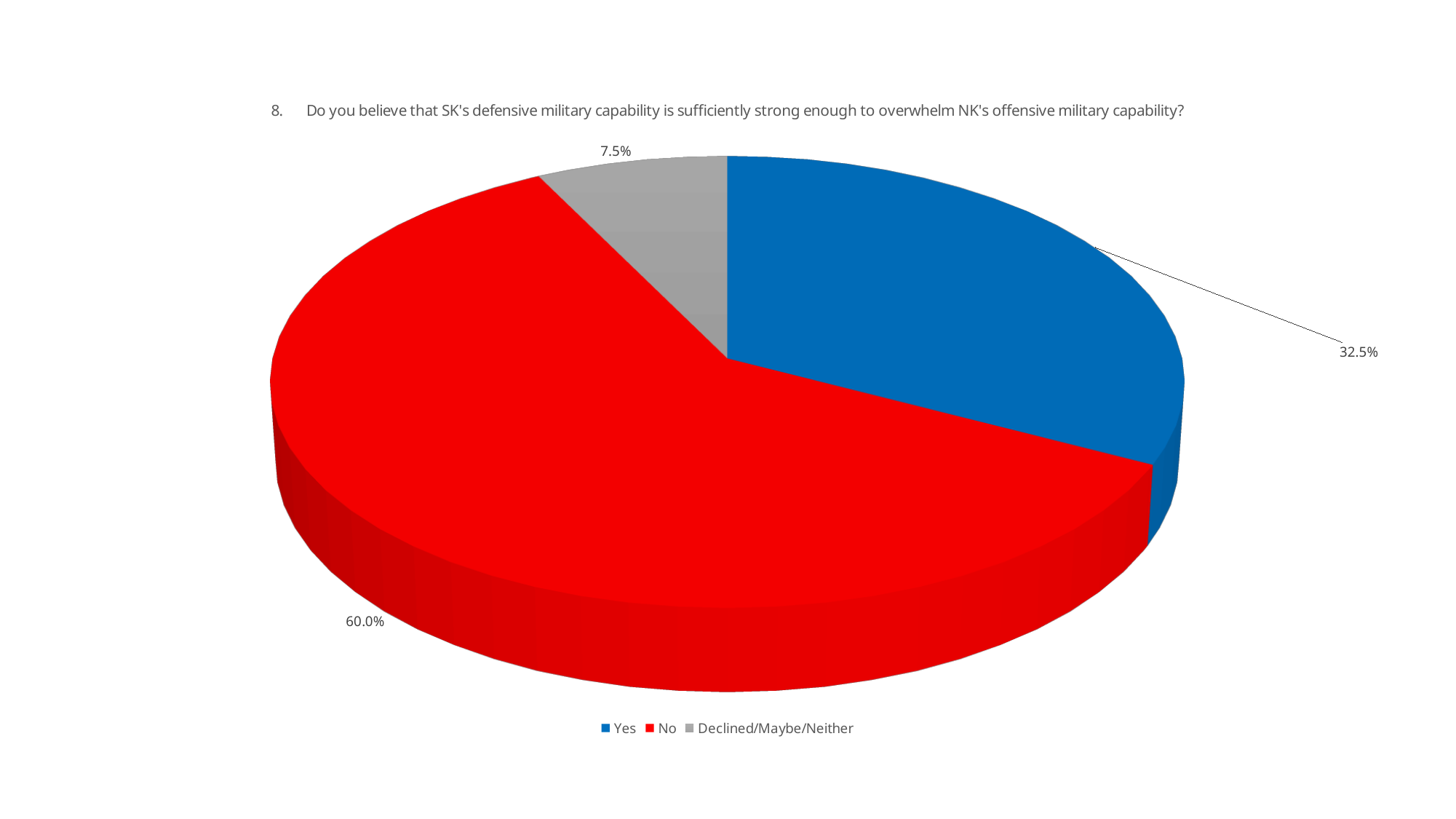
Which category is shown in grey in the legend? Declined/Maybe/Neither What share of the pie does the "Yes" slice represent? 32.5% How many categories does the pie chart show? 3 What kind of chart is shown on the slide? Pie chart What is the difference in percentage points between the "No" and "Yes" slices? 27.5 What is the difference in percentage points between the "Yes" and "Declined/Maybe/Neither" slices? 25.0 What share of the pie does the "Declined/Maybe/Neither" slice represent? 7.5% What colour is the "No" slice in the pie chart? Red Which category has the smallest slice of the pie? Declined/Maybe/Neither Which category has the largest slice of the pie? No What share of the pie does the "No" slice represent? 60.0% Which is larger, the "Yes" slice or the "No" slice? No